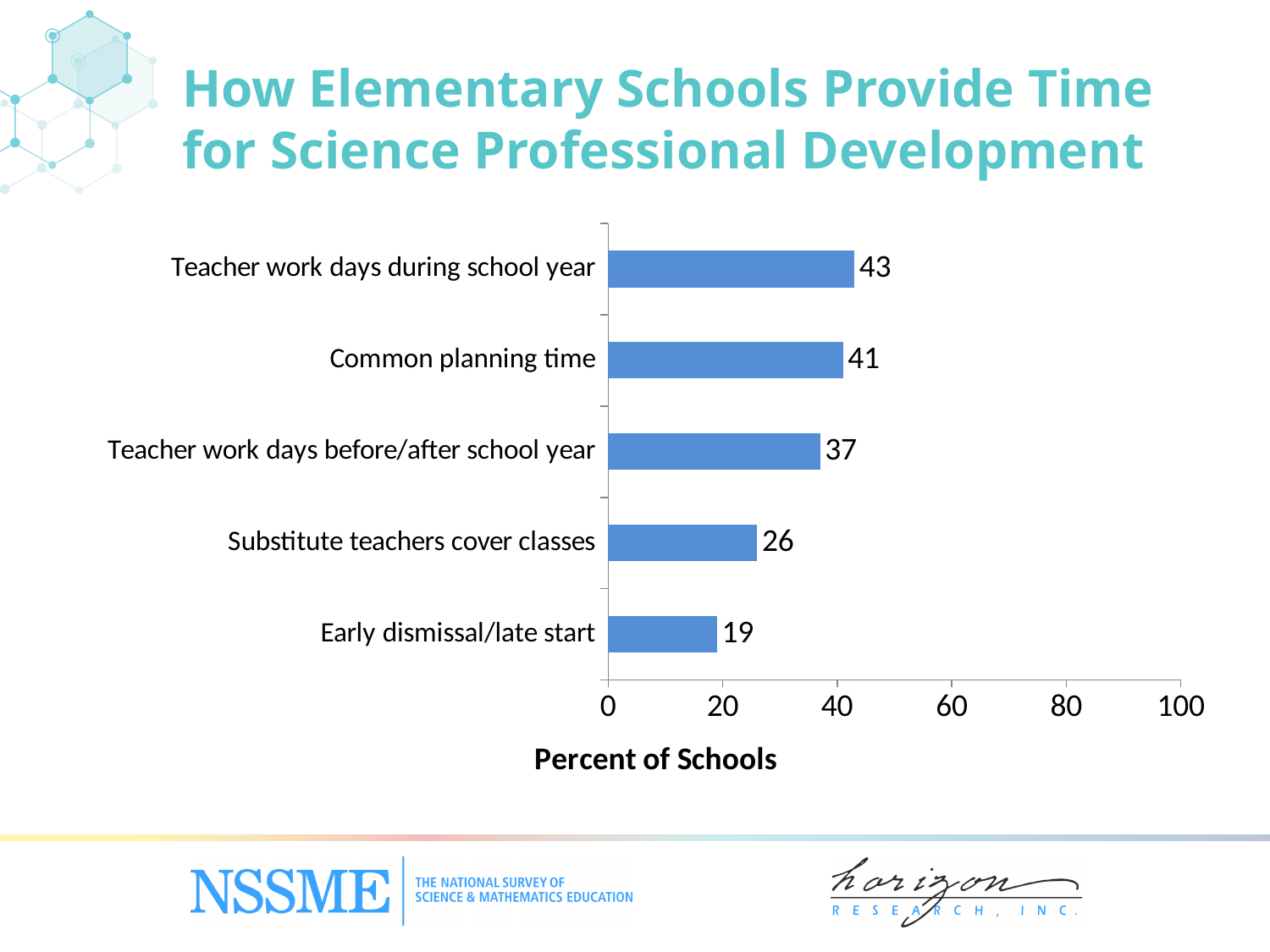
What percent of schools provide time for science professional development through teacher work days during the school year? 43 Is the value for Common planning time greater or less than 60? less What is the difference between the values for Teacher work days before/after school year and Early dismissal/late start? 18 Which category has the highest percent of schools? Teacher work days during school year What is the label of the horizontal axis? Percent of Schools What kind of chart is shown on the slide? Bar chart What is the value for Common planning time? 41 Which is larger, the value for Substitute teachers cover classes or the value for Teacher work days before/after school year? Teacher work days before/after school year What is the value for Early dismissal/late start? 19 What is the value for Substitute teachers cover classes? 26 How many categories are shown in the chart? 5 Which category has the lowest percent of schools? Early dismissal/late start